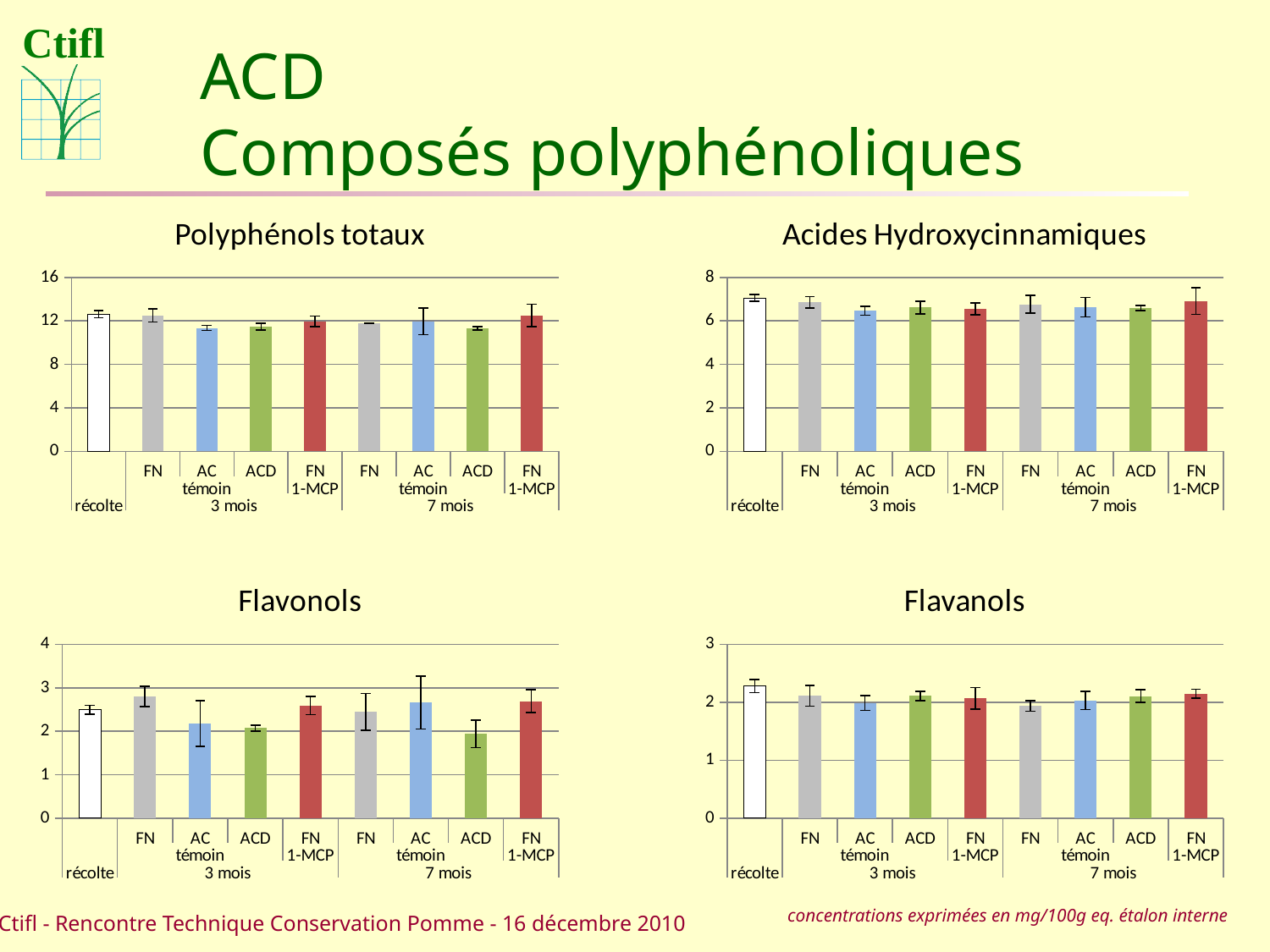
In the "Polyphénols totaux" chart, is the value for AC témoin at 3 mois greater or less than 12? less In the "Flavanols" chart, which bar is the highest? récolte In the "Acides Hydroxycinnamiques" chart, is the value for récolte greater or less than 6? greater In the "Flavonols" chart, which bar is the lowest? ACD at 7 mois In the "Flavonols" chart, which is larger: FN at 3 mois or ACD at 3 mois? FN at 3 mois In the "Polyphénols totaux" chart, is the value for récolte greater or less than 12? greater What is the title of the chart in the bottom-right of the slide? Flavanols What kind of chart is the "Polyphénols totaux" chart? bar chart According to the note at the bottom of the slide, in what unit are the concentrations expressed? mg/100g eq. étalon interne How many bars are plotted in the "Flavonols" chart? 9